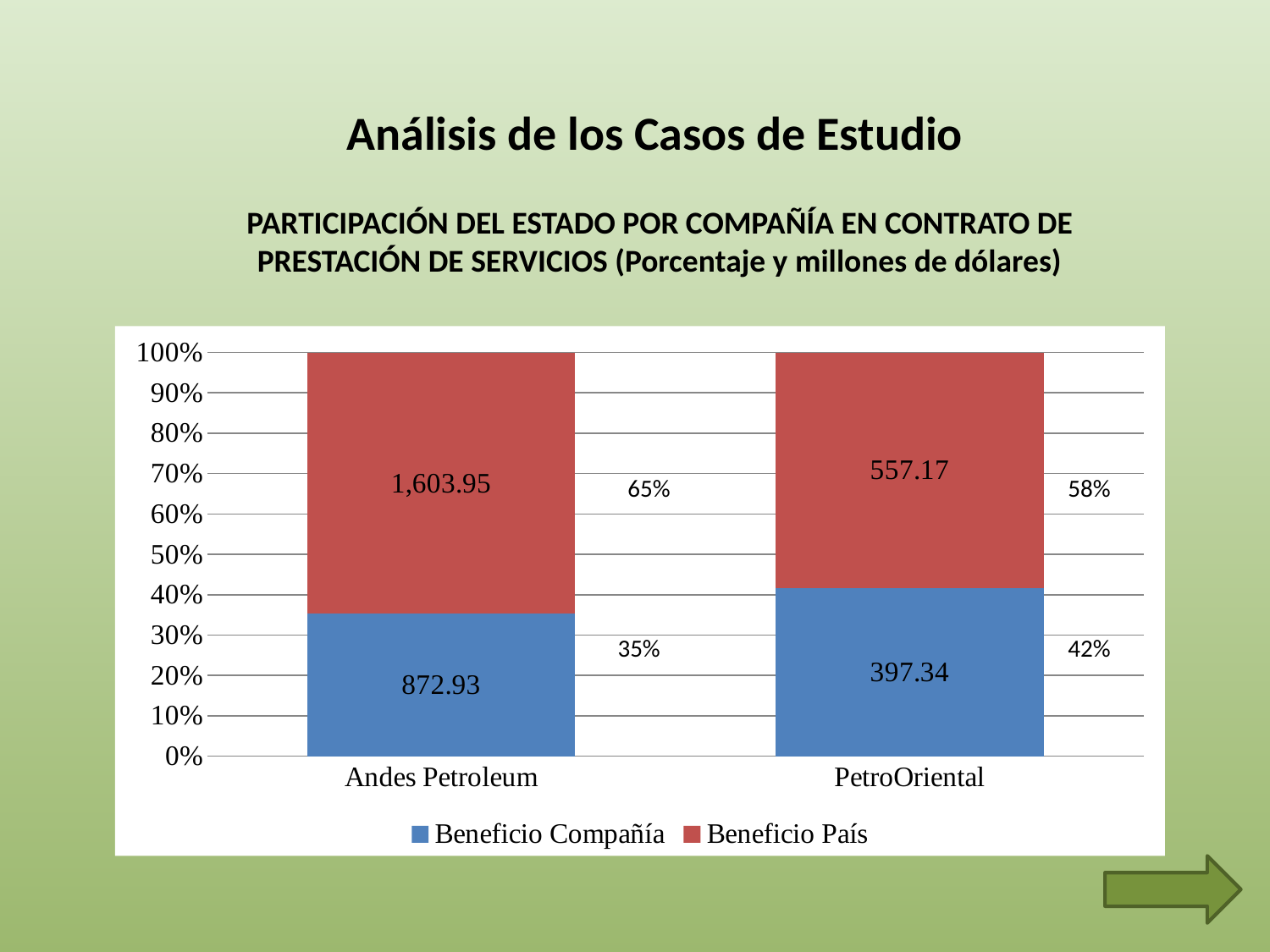
What is the Beneficio Compañía value for PetroOriental? 397.34 Which company has the larger Beneficio País value, Andes Petroleum or PetroOriental? Andes Petroleum What percentage share is shown next to the Beneficio País segment for Andes Petroleum? 65% What is the total of the two segments for Andes Petroleum? 2,476.88 How many series does the legend list? 2 What is the Beneficio País value for Andes Petroleum? 1,603.95 What kind of chart is shown on the slide? Stacked bar chart What is the difference between the Beneficio País and Beneficio Compañía values for PetroOriental? 159.83 What is the Beneficio Compañía value for Andes Petroleum? 872.93 How many companies are shown on the x axis? 2 What percentage share is shown next to the Beneficio Compañía segment for PetroOriental? 42% What is the Beneficio País value for PetroOriental? 557.17